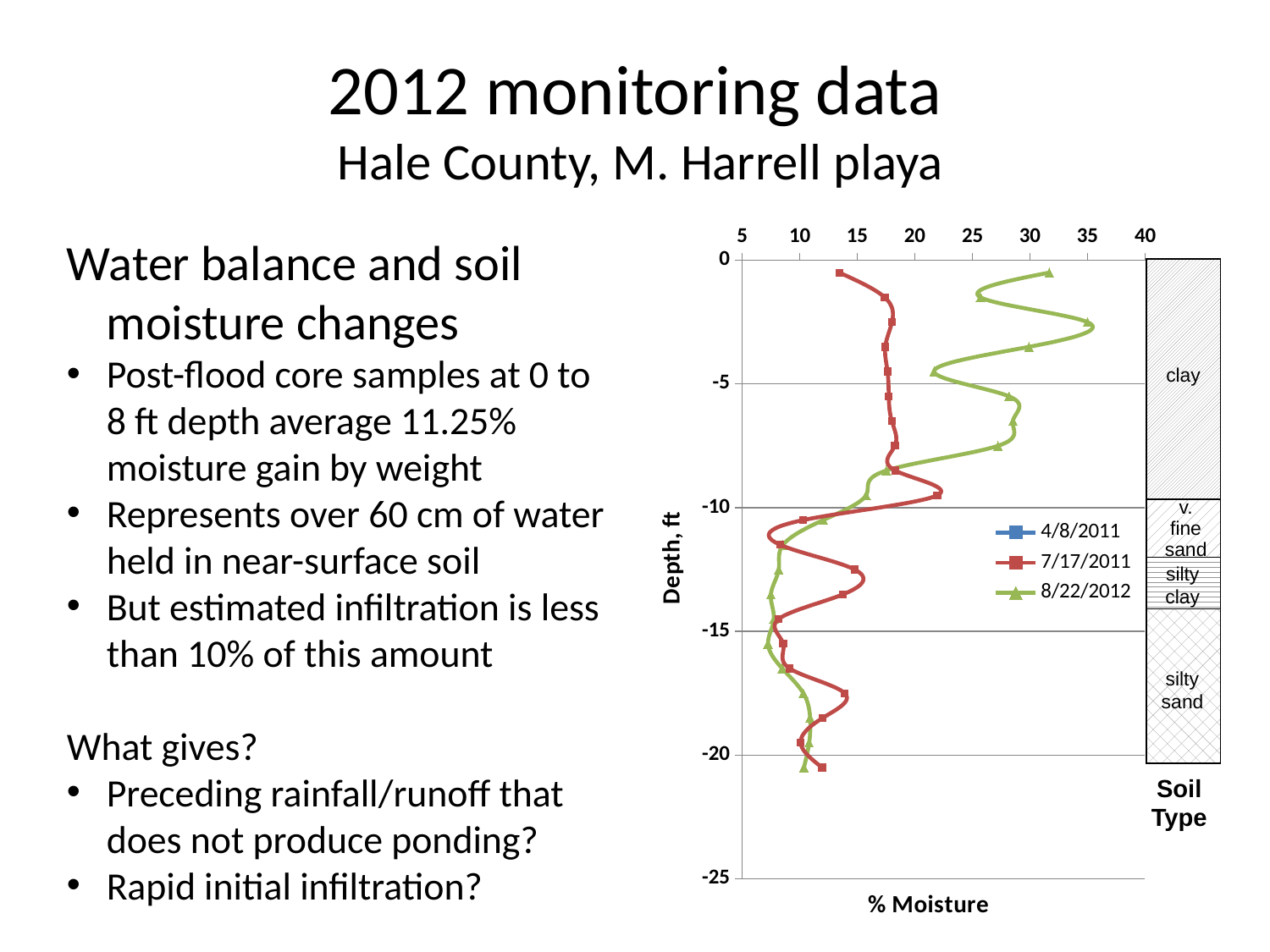
At -5 ft depth, which series shows the higher % Moisture, 7/17/2011 or 8/22/2012? 8/22/2012 Is the % Moisture value of the 7/17/2011 series at the surface (0 ft depth) greater or less than 15? less At about -13 ft depth, which series shows the higher % Moisture, 7/17/2011 or 8/22/2012? 7/17/2011 What is the title of the chart's y axis? Depth, ft Is the % Moisture value of the 7/17/2011 series at about -9.5 ft depth greater or less than 20? greater What kind of chart is shown on the slide? line chart How many series does the chart legend list? 3 Is the % Moisture value of the 8/22/2012 series at about -15 ft depth greater or less than 10? less Between 0 and -8 ft depth, is the 8/22/2012 series generally higher or lower in % Moisture than the 7/17/2011 series? higher Which series reaches the highest % Moisture value anywhere on the chart? 8/22/2012 What is the title of the chart's x axis? % Moisture